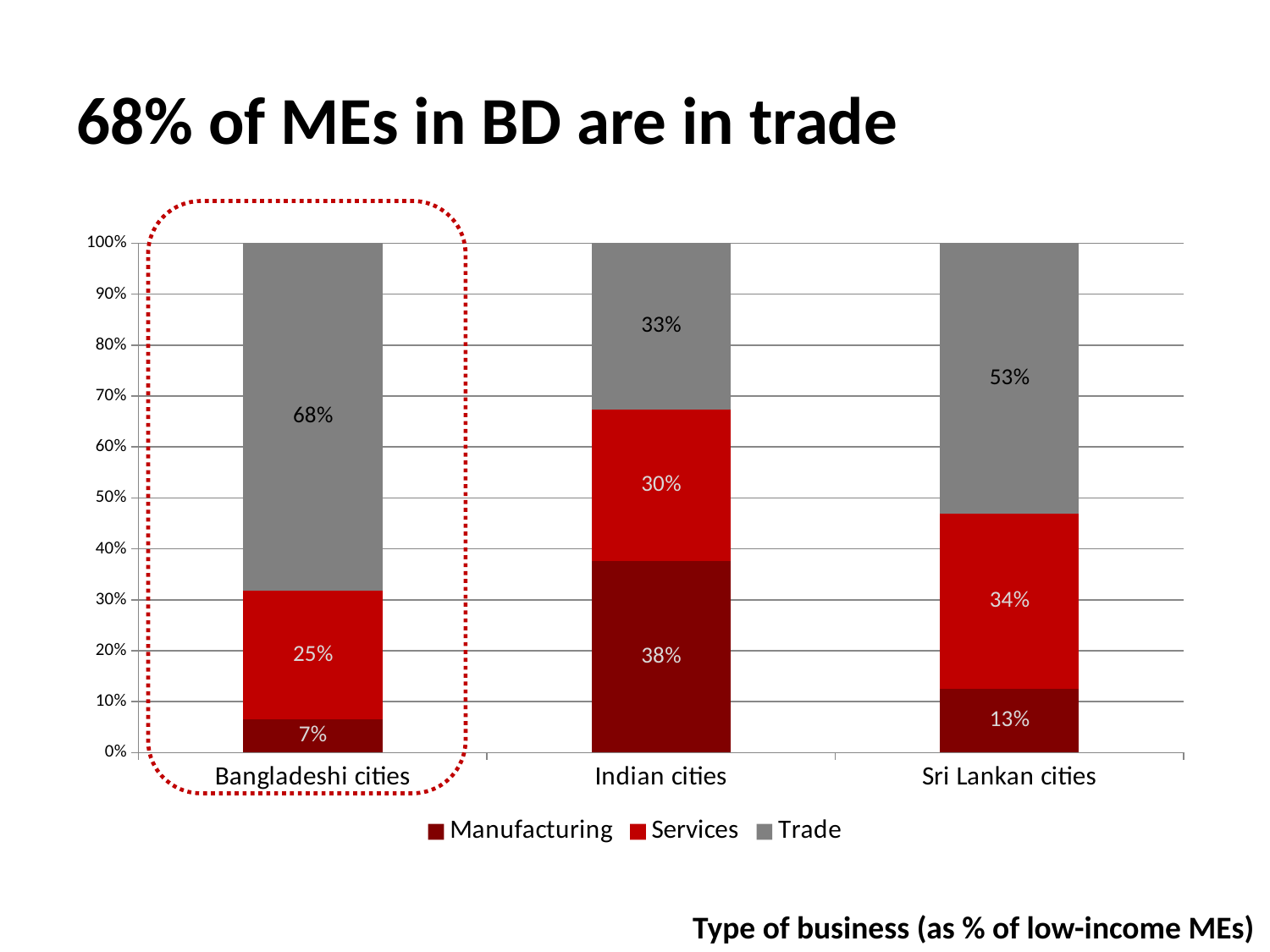
What is the Trade share for Bangladeshi cities? 68% What is the Manufacturing share for Indian cities? 38% Which city group has the highest Trade share? Bangladeshi cities How many series does the legend list? 3 What is the difference between the Trade share in Bangladeshi cities and in Indian cities? 35% Which series is shown in grey in the legend? Trade Which category on the chart is outlined with a dotted red box? Bangladeshi cities How many city groups are shown on the x axis? 3 Which city group has the lowest Manufacturing share? Bangladeshi cities What kind of chart is shown on the slide? Stacked bar chart What is the Services share for Sri Lankan cities? 34% Which is larger: the Services share in Indian cities or in Sri Lankan cities? Sri Lankan cities